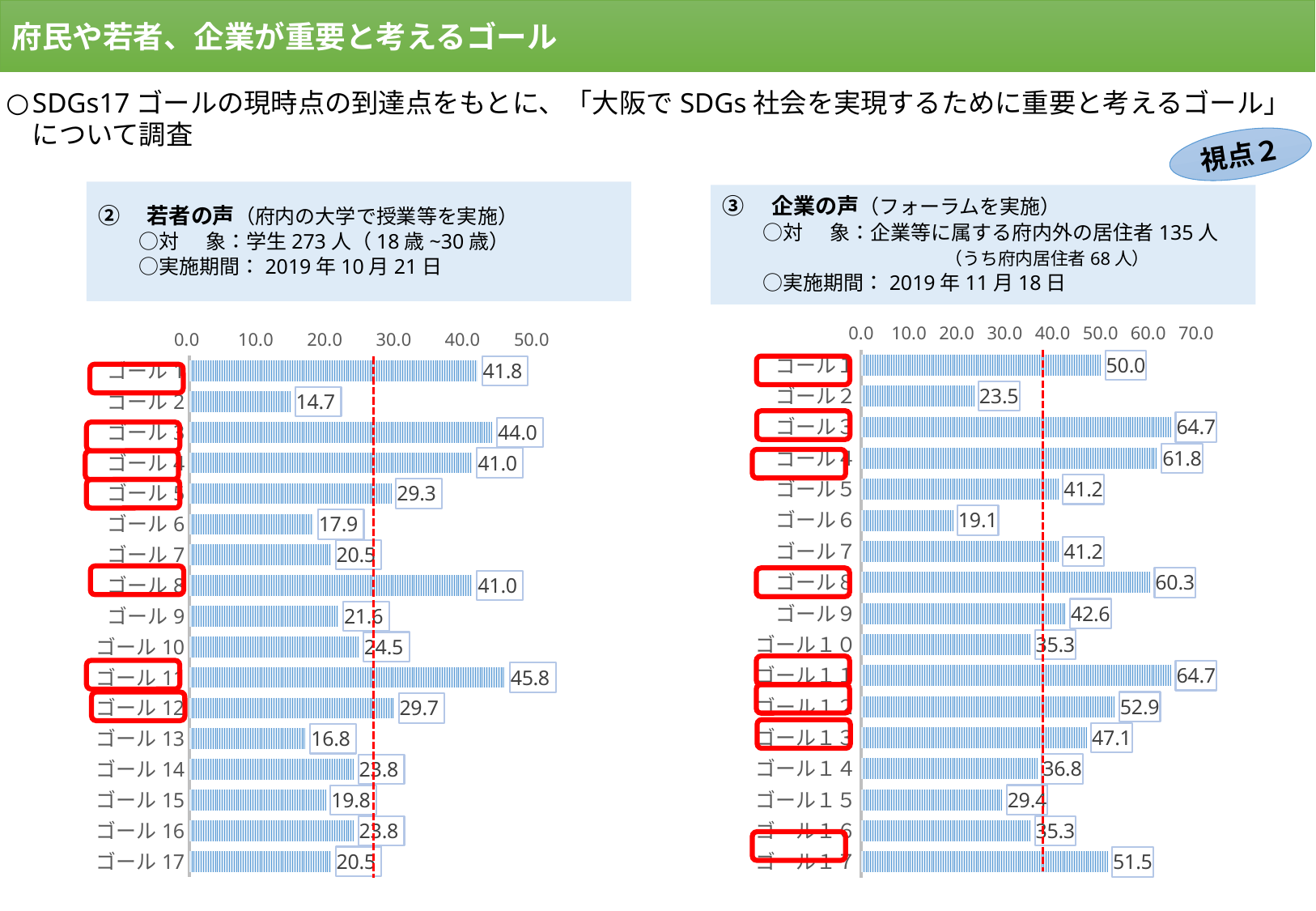
What kind of chart is the left chart (若者の声)? Bar chart In the left chart (若者の声), what is the value for ゴール 1? 41.8 In the left chart (若者の声), which goal has the highest value? ゴール 11 In the right chart (企業の声), what is the difference between the values for ゴール 3 and ゴール 2? 41.2 In the left chart (若者の声), which is larger, the value for ゴール 5 or the value for ゴール 13? ゴール 5 How many goals (categories) are plotted in the right chart (企業の声)? 17 In the left chart (若者の声), which goal has the lowest value? ゴール 2 In the right chart (企業の声), is the value for ゴール 12 greater or less than 50.0? greater In the right chart (企業の声), which goal has the lowest value? ゴール 6 In the left chart (若者の声), what is the difference between the values for ゴール 11 and ゴール 12? 16.1 In the right chart (企業の声), what is the value for ゴール 17? 51.5 In the right chart (企業の声), what is the value for ゴール 8? 60.3